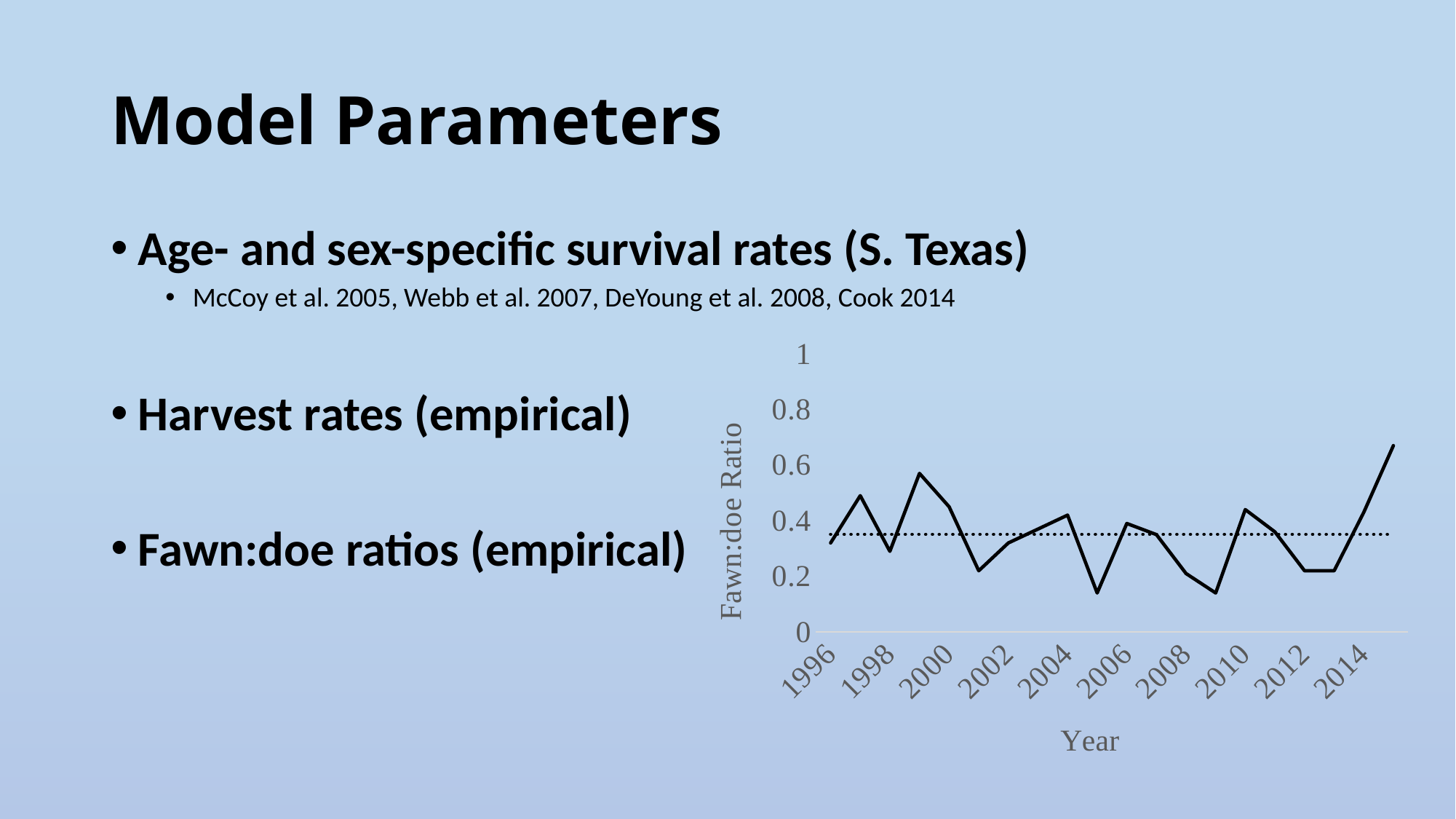
Which year has the larger fawn:doe ratio, 1999 or 2001? 1999 Is the fawn:doe ratio for 1996 greater or less than 0.4? less What kind of chart is shown on the slide? line chart How many year labels are printed along the x axis of the chart? 10 What is the label on the horizontal axis of the chart? Year What is the label on the vertical axis of the chart? Fawn:doe Ratio Which year has the highest fawn:doe ratio on the chart? 2015 Is the fawn:doe ratio for 2006 greater or less than 0.2? greater Is the fawn:doe ratio for 1999 greater or less than 0.4? greater Does the fawn:doe ratio rise or fall between 2013 and 2015? rise